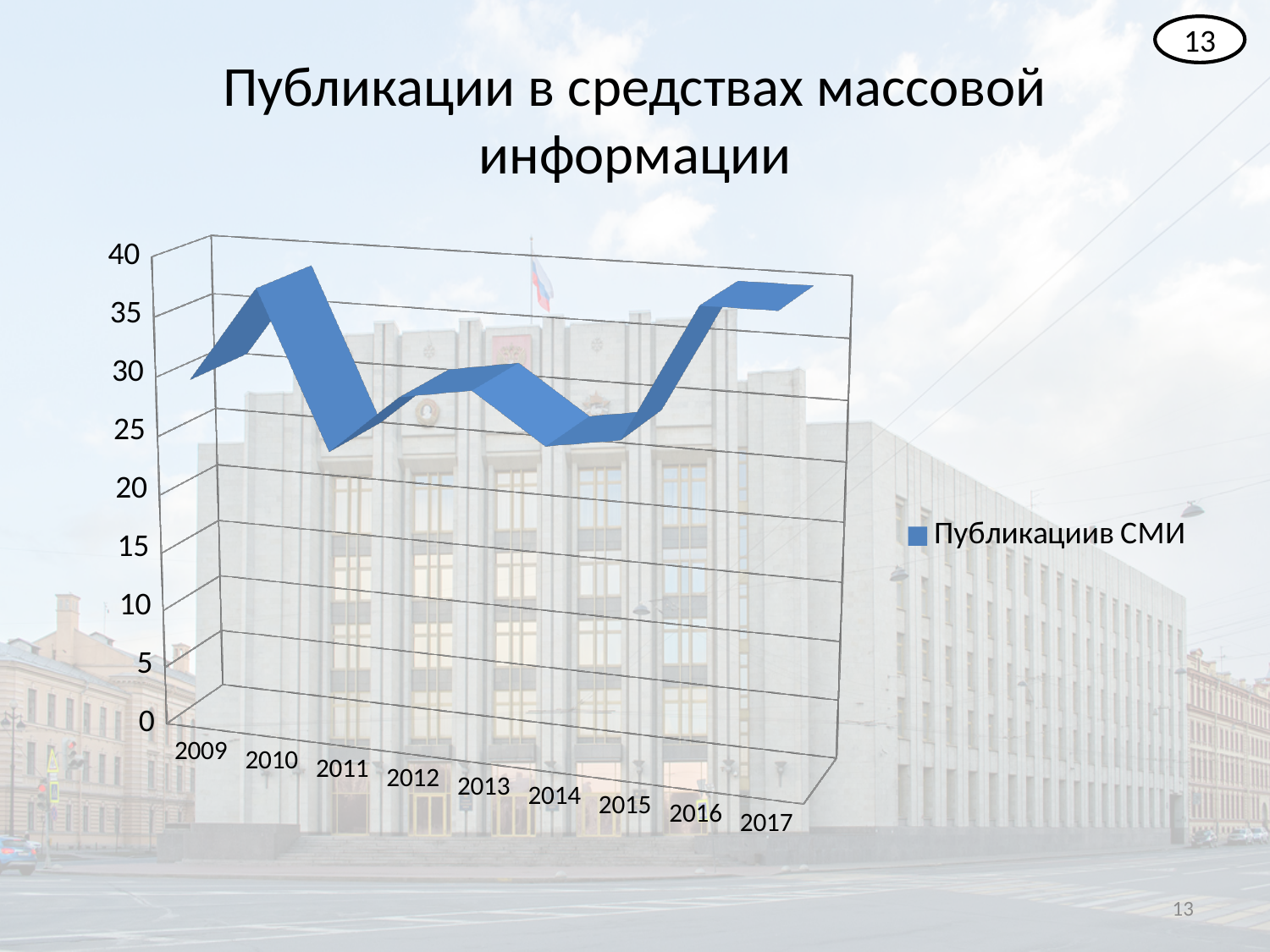
What is the title of the chart on the slide? Публикации в средствах массовой информации Is the value for 2014 greater or less than 30? less How many years are plotted along the x axis of the chart? 9 What is the legend entry for the plotted series? Публикациив СМИ Which year has the larger value, 2015 or 2016? 2016 Is the value for 2010 greater or less than 35? greater Is the value for 2016 greater or less than 30? greater Which year has the larger value, 2010 or 2011? 2010 Do the values rise or fall from 2014 to 2016? rise What kind of chart is shown on the slide? line chart How many series does the chart legend list? 1